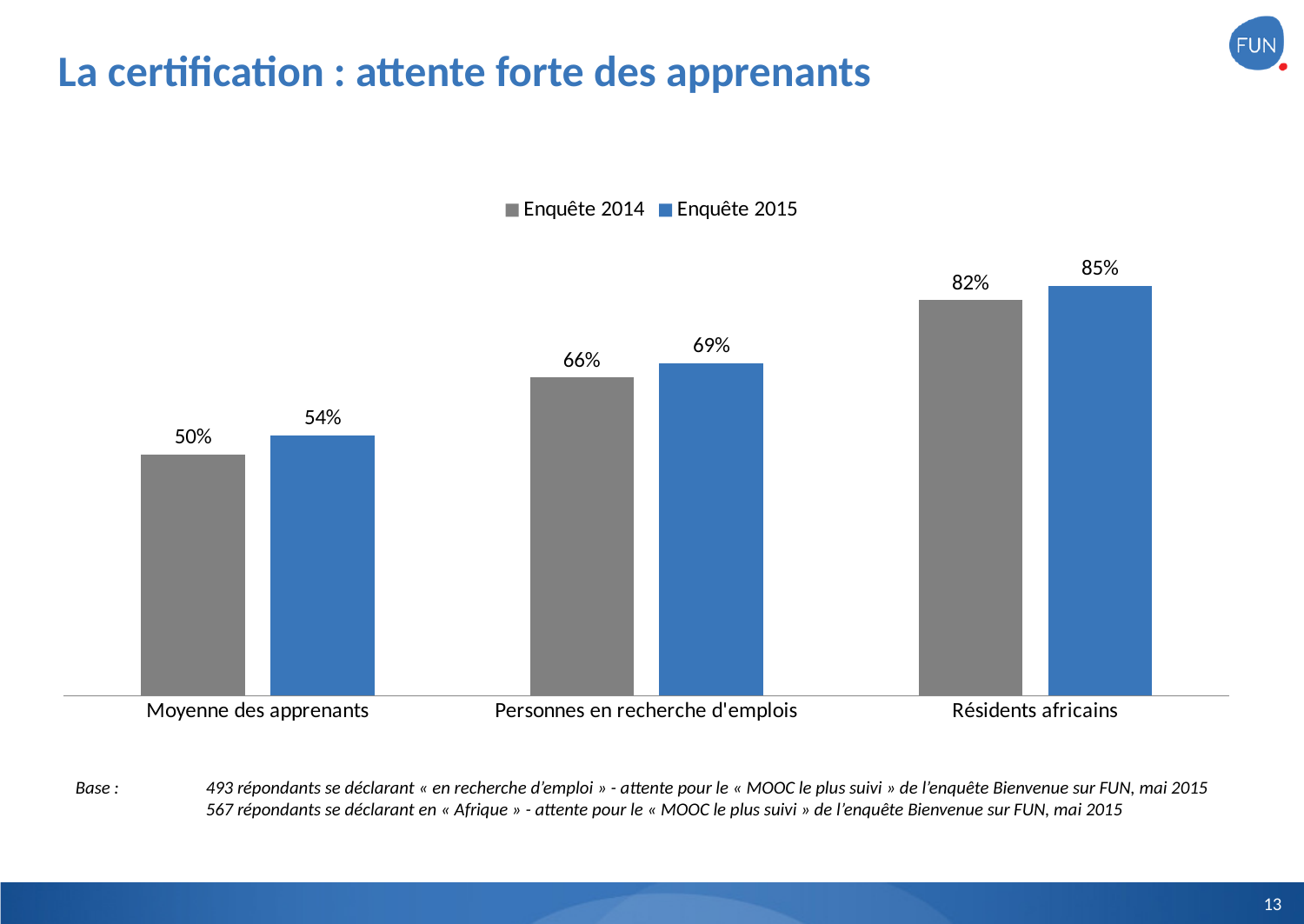
What is the difference between Enquête 2015 and Enquête 2014 for Moyenne des apprenants? 4% What is the value for Enquête 2015 for Résidents africains? 85% Which is larger: Enquête 2014 for Résidents africains or Enquête 2015 for Personnes en recherche d'emplois? Enquête 2014 for Résidents africains What kind of chart is shown on the slide? Bar chart Which category has the highest value for Enquête 2014? Résidents africains What is the value for Enquête 2015 for Personnes en recherche d'emplois? 69% What is the value for Enquête 2014 for Moyenne des apprenants? 50% Which category has the lowest value for Enquête 2015? Moyenne des apprenants How many series does the legend list? 2 What is the difference between Enquête 2015 and Enquête 2014 for Personnes en recherche d'emplois? 3% Which colour represents Enquête 2015 in the legend? Blue How many categories are shown on the x axis? 3